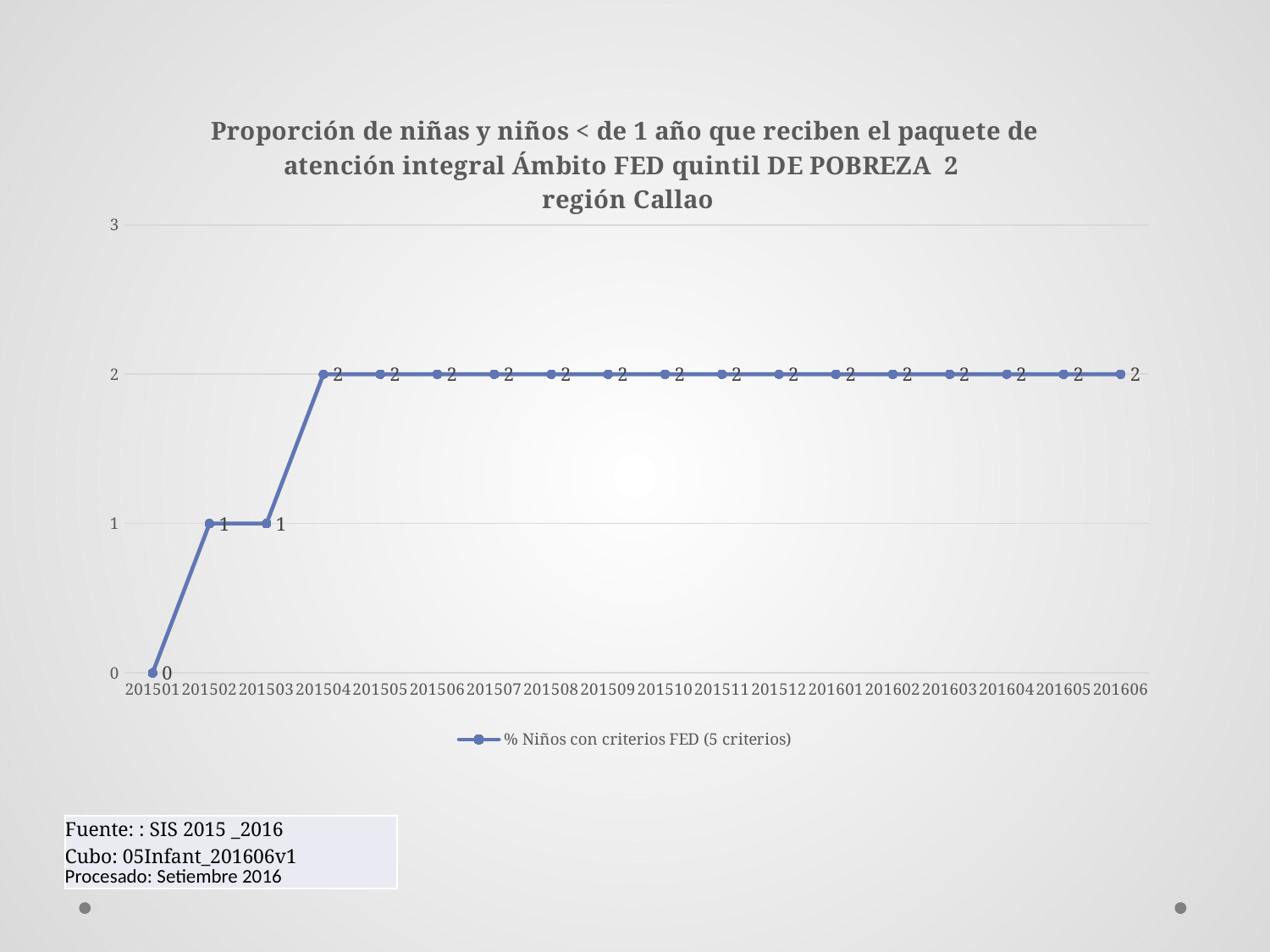
What type of chart is shown on the slide? line chart What is the value for 201504? 2 How many periods are plotted on the x axis? 18 What is the difference between the values for 201606 and 201501? 2 Which is larger, the value for 201502 or the value for 201505? 201505 How many series does the legend list? 1 Do the values rise or fall from 201501 to 201504? rise What is the value for 201501? 0 What is the difference between the values for 201504 and 201503? 1 Which period has the lowest value? 201501 What is the value for 201502? 1 What is the value for 201606? 2